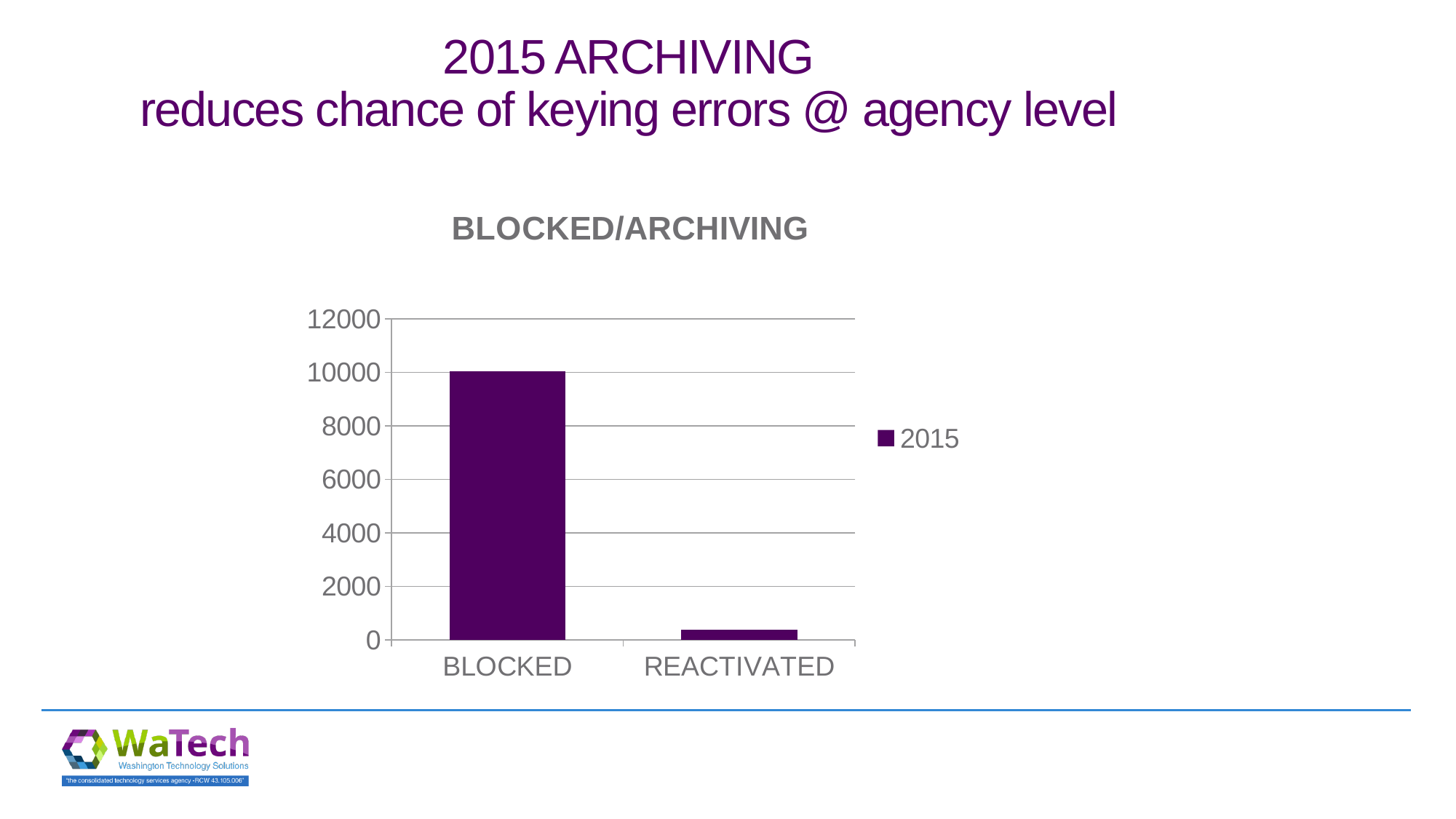
What is the title of the chart? BLOCKED/ARCHIVING Is the value for REACTIVATED greater or less than 2000? less Which is larger, the value for BLOCKED or the value for REACTIVATED? BLOCKED What kind of chart is shown on the slide? bar chart How many series does the chart's legend list? 1 Which category has the lowest value in the chart? REACTIVATED What series name appears in the chart's legend? 2015 Which category has the highest value in the chart? BLOCKED Is the value for BLOCKED greater or less than 8000? greater How many categories are shown on the x axis of the chart? 2 Do the values rise or fall from BLOCKED to REACTIVATED along the x axis? fall